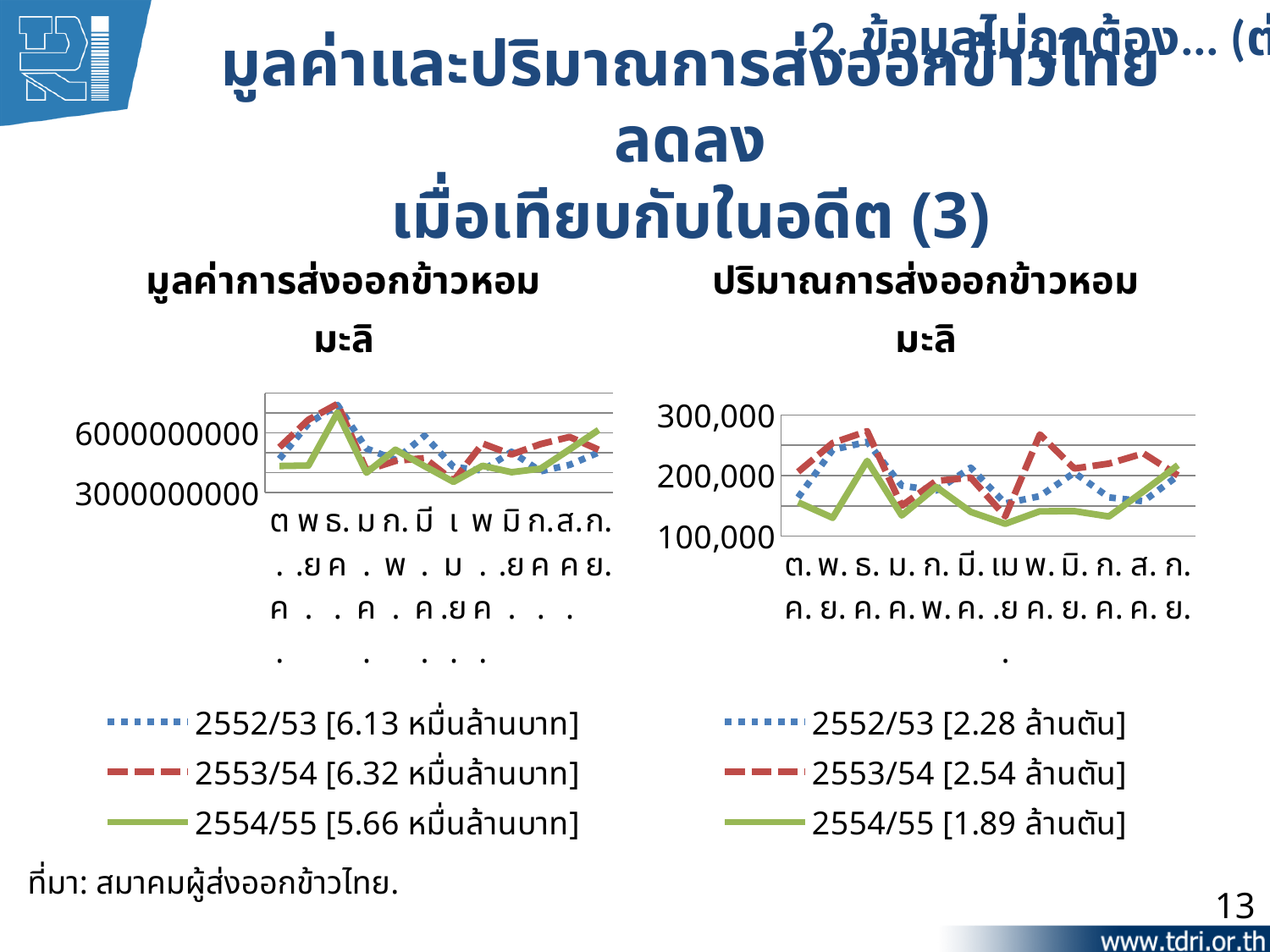
How many months are plotted along the x axis of the right chart titled ปริมาณการส่งออกข้าวหอมมะลิ? 12 In the left chart titled มูลค่าการส่งออกข้าวหอมมะลิ, is the value for 2554/55 in ต.ค. greater or less than 6000000000? less In the right chart titled ปริมาณการส่งออกข้าวหอมมะลิ, is the value for 2554/55 in ต.ค. greater or less than 200,000? less What total is shown in the legend of the right chart titled ปริมาณการส่งออกข้าวหอมมะลิ for the 2554/55 series? 1.89 ล้านตัน In the right chart titled ปริมาณการส่งออกข้าวหอมมะลิ, which series is higher in ธ.ค., 2553/54 or 2554/55? 2553/54 What total is shown in the legend of the left chart titled มูลค่าการส่งออกข้าวหอมมะลิ for the 2553/54 series? 6.32 หมื่นล้านบาท In the right chart titled ปริมาณการส่งออกข้าวหอมมะลิ, is the value for 2553/54 in ธ.ค. greater or less than 200,000? greater What kind of chart is the left chart titled มูลค่าการส่งออกข้าวหอมมะลิ? line chart How many series does the legend of the right chart titled ปริมาณการส่งออกข้าวหอมมะลิ list? 3 In the right chart titled ปริมาณการส่งออกข้าวหอมมะลิ, which series is lowest in มี.ค.? 2554/55